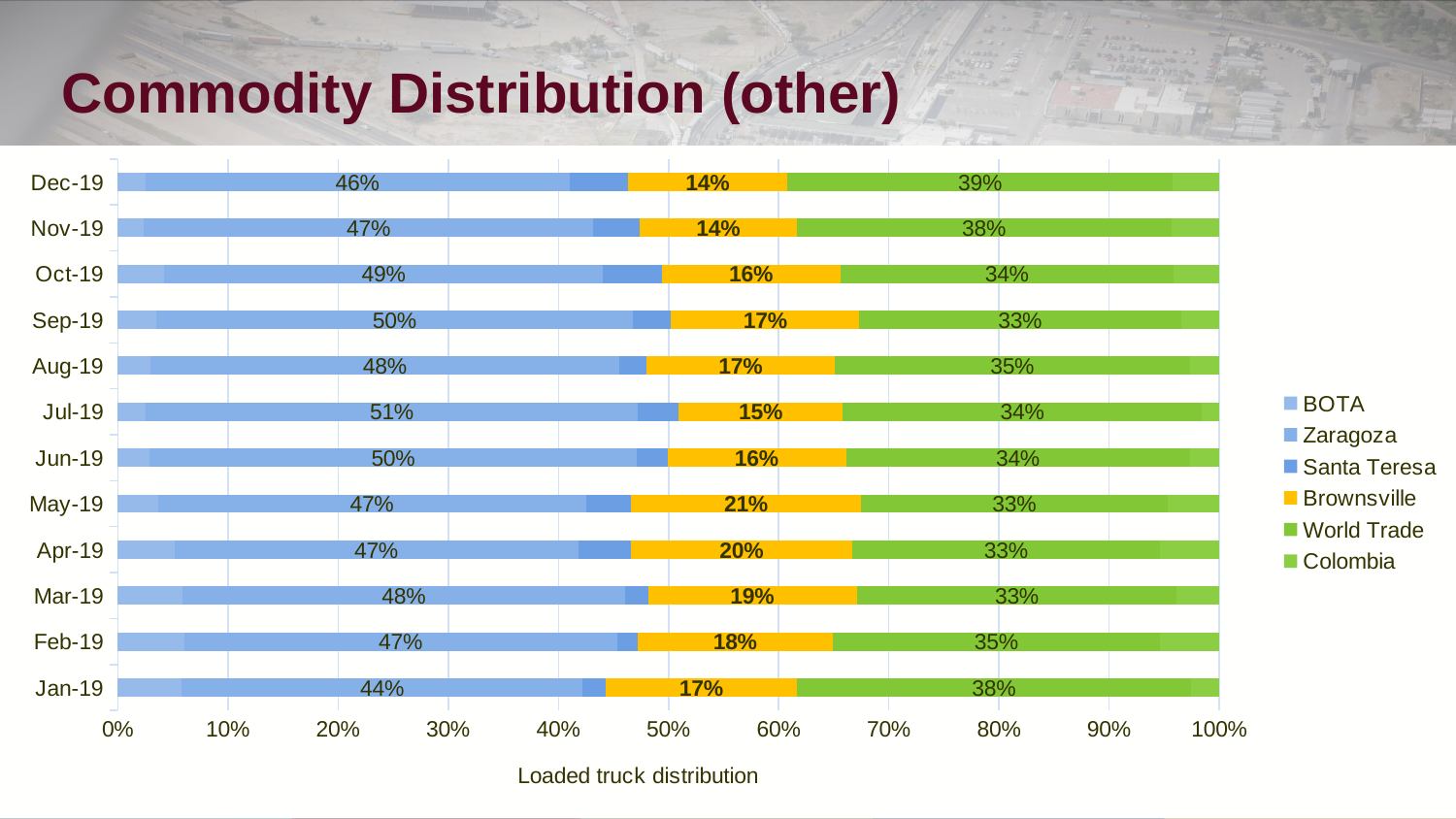
How many series does the legend list? 6 What percentage label is shown on the blue portion of the Jul-19 bar? 51% Which month has the larger Brownsville share, Mar-19 or Aug-19? Mar-19 What kind of chart is shown on the slide? Stacked bar chart What is the title shown below the horizontal axis of the chart? Loaded truck distribution Does the Brownsville share rise or fall from Jan-19 to May-19? Rises How many months are shown on the vertical axis of the chart? 12 What is the Brownsville share for May-19? 21% What percentage label is shown on the green portion of the Jan-19 bar? 38% In which month is the Brownsville share highest? May-19 What is the difference between the Brownsville share in May-19 and in Jan-19? 4 percentage points What is the Brownsville share for Dec-19? 14%